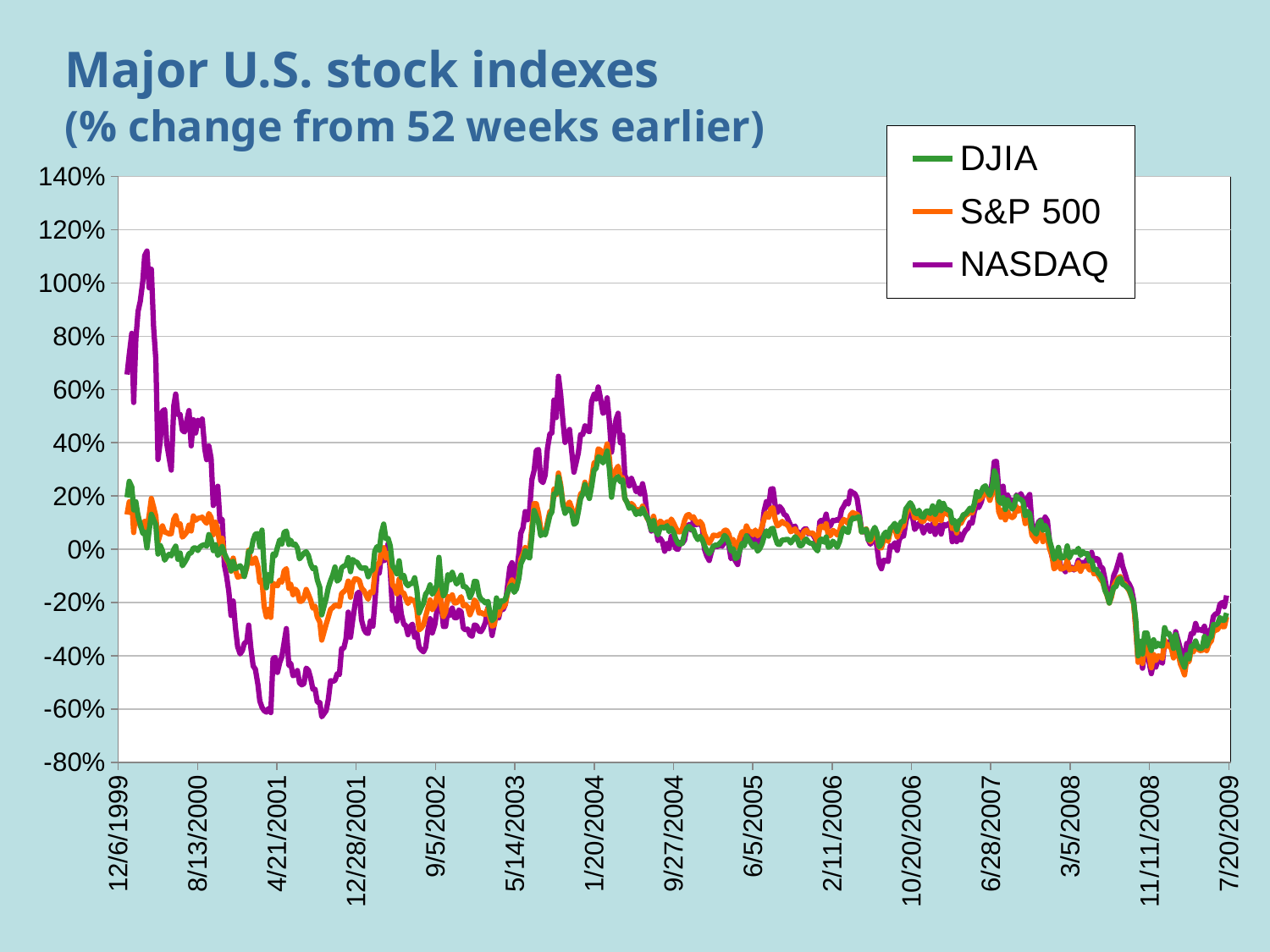
What is the title of the chart? Major U.S. stock indexes (% change from 52 weeks earlier) At the start of the chart (12/6/1999), which is higher, NASDAQ or DJIA? NASDAQ Which series reaches the highest value anywhere on the chart? NASDAQ What kind of chart is shown on the slide? line chart Is the DJIA value at 12/6/1999 greater or less than 0%? greater Between 6/28/2007 and 11/11/2008, do the values of the three indexes rise or fall? fall How many series does the legend list? 3 Is the NASDAQ value around 11/11/2008 greater or less than -20%? less Is the peak value of NASDAQ in early 2000 greater or less than 100%? greater Which series is drawn in purple? NASDAQ Which series reaches the lowest value anywhere on the chart? NASDAQ